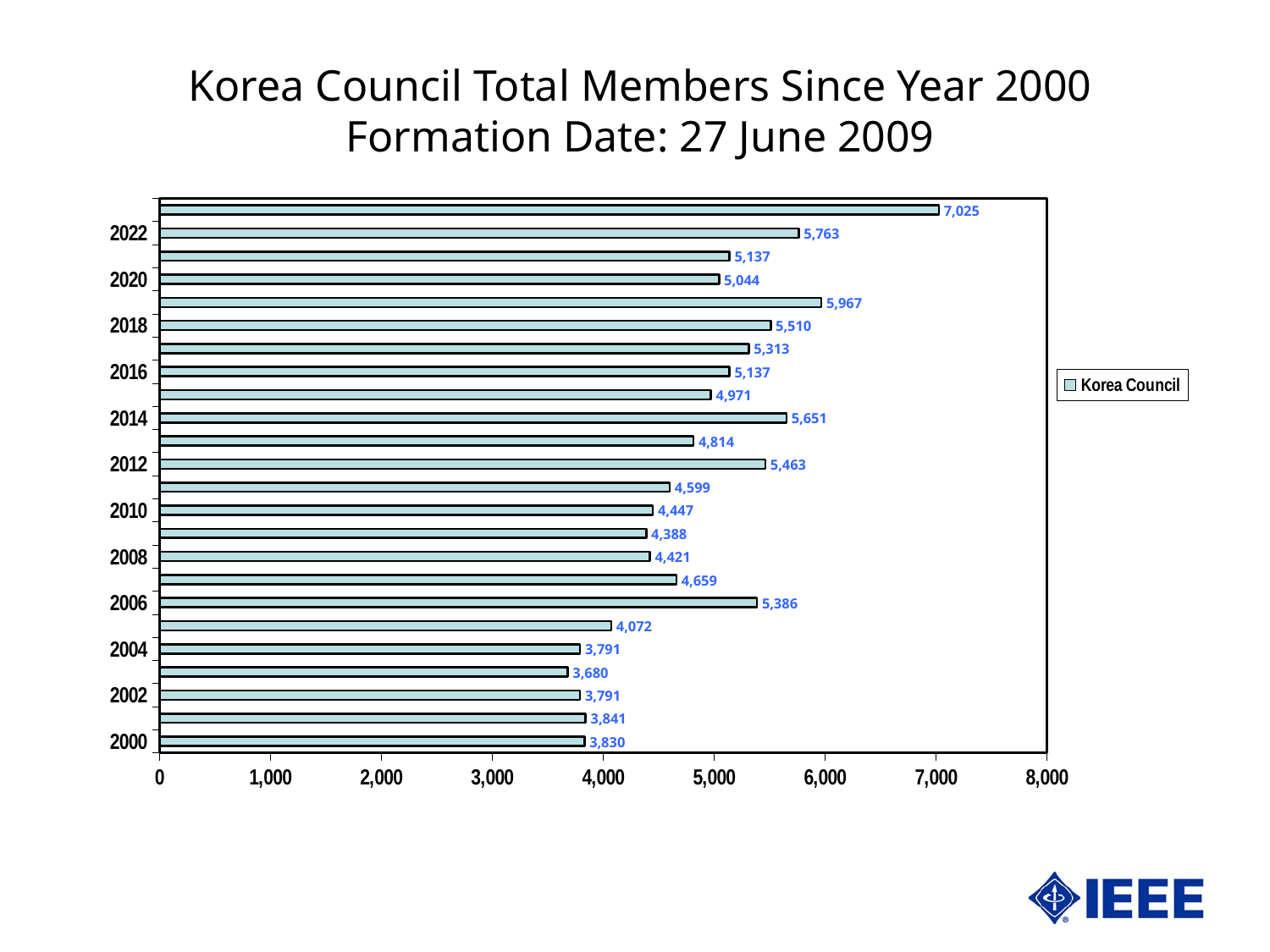
What is the value for 2000? 3,830 Is the value for 2018 greater or less than 5,000? greater What kind of chart is shown? bar chart What is the value for 2022? 5,763 What series name does the legend show? Korea Council What is the value for 2014? 5,651 How many bars are plotted in the chart? 24 Which is larger, the value for 2012 or the value for 2010? 2012 What is the difference between the values for 2022 and 2020? 719 Which year has the highest value? 2023 What is the value for 2006? 5,386